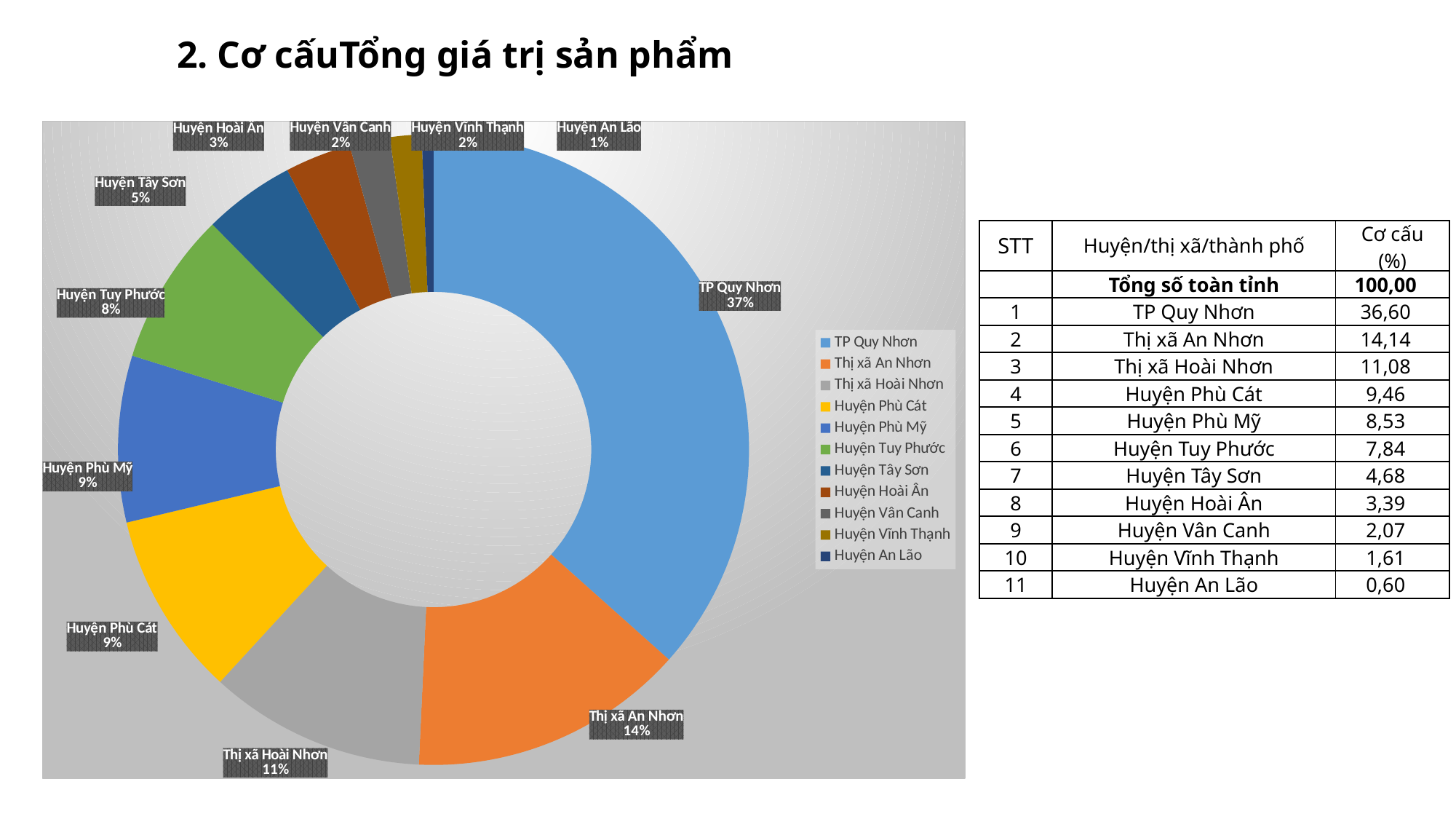
Which category has the largest slice in the chart? TP Quy Nhơn What percentage is labelled for Huyện Tây Sơn on the chart? 5% Which category has the smallest slice in the chart? Huyện An Lão Which legend entry is listed first in the chart's legend? TP Quy Nhơn Which slice is larger, Huyện Tuy Phước or Huyện Tây Sơn? Huyện Tuy Phước By how many percentage points does the TP Quy Nhơn slice exceed the Thị xã An Nhơn slice, based on the chart labels? 23 percentage points What type of chart is shown on the slide? Doughnut (pie) chart What percentage is labelled for Huyện Tuy Phước on the chart? 8% How many categories (slices) does the chart show? 11 What colour is the slice for Thị xã An Nhơn in the chart? Orange What share of the doughnut chart does TP Quy Nhơn hold according to its data label? 37% What percentage is shown for Thị xã An Nhơn on the chart? 14%